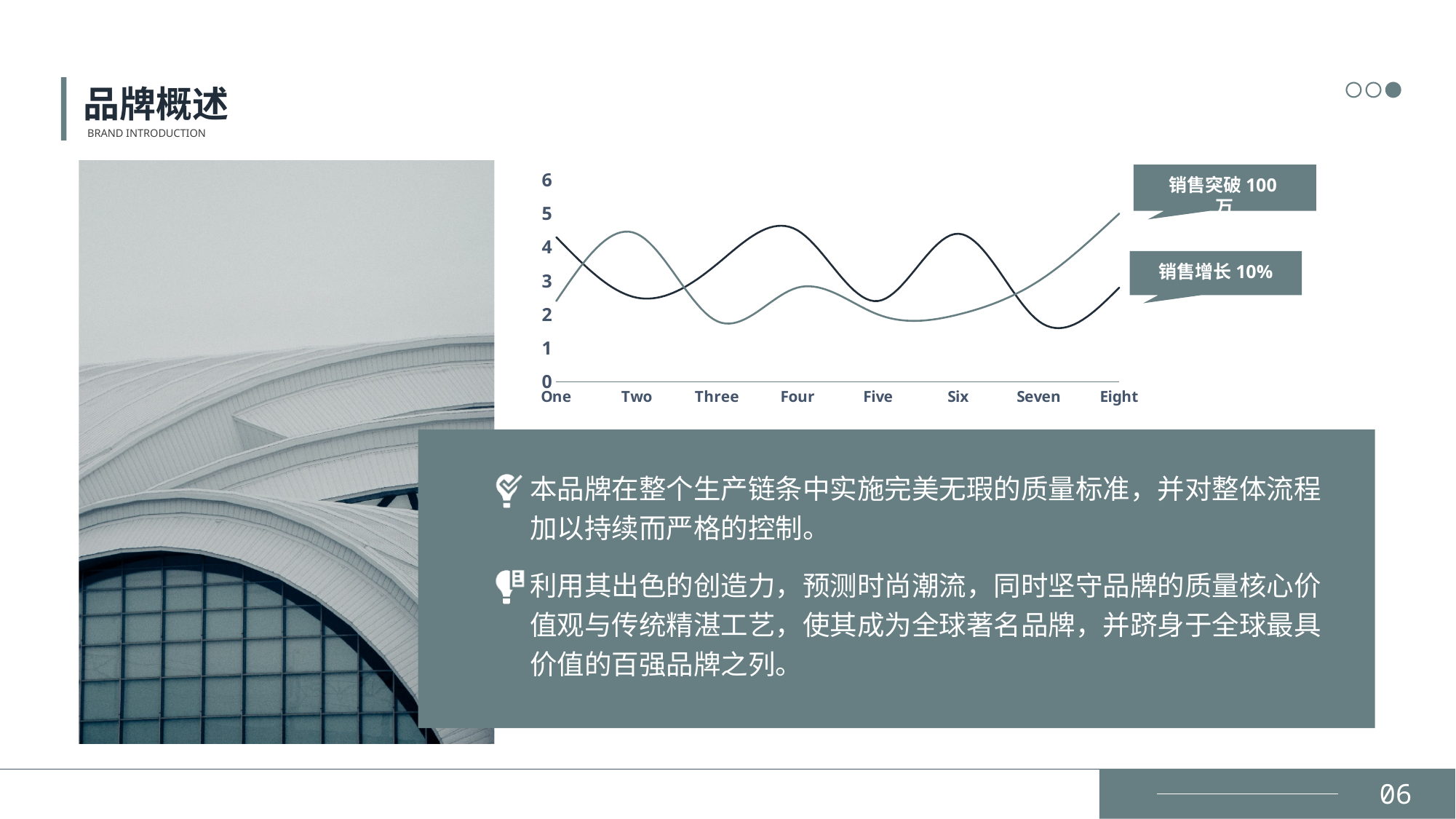
Is the value of the grey-green line at Eight greater or less than 4? greater At Eight, which line has the higher value, the dark navy line or the grey-green line? the grey-green line At Four, which line has the higher value, the dark navy line or the grey-green line? the dark navy line At which category does the grey-green line reach its highest value? Eight Is the value of the dark navy line at Seven greater or less than 2? less How many lines are plotted in the chart? 2 Is the value of the grey-green line at Two greater or less than 3? greater How many categories are shown on the x axis of the chart? 8 What kind of chart is shown on the slide? line chart At which category does the dark navy line reach its lowest value? Seven